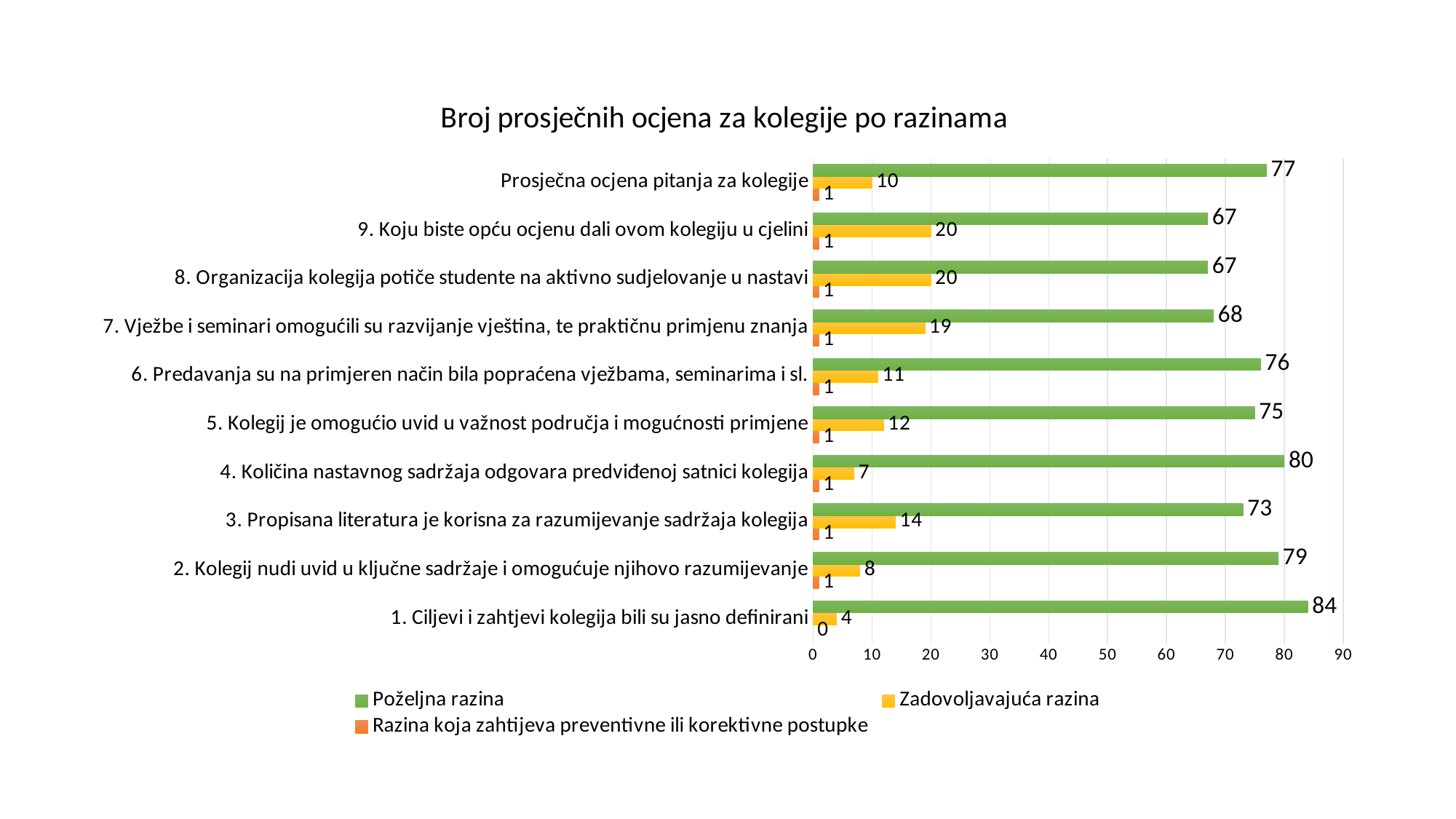
How many series does the legend list? 3 What is the value of 'Razina koja zahtijeva preventivne ili korektivne postupke' for '1. Ciljevi i zahtjevi kolegija bili su jasno definirani'? 0 How many categories are shown on the chart? 10 What is the total of the three values for 'Prosječna ocjena pitanja za kolegije'? 88 What is the title of the chart? Broj prosječnih ocjena za kolegije po razinama What is the value of 'Poželjna razina' for '1. Ciljevi i zahtjevi kolegija bili su jasno definirani'? 84 What kind of chart is shown on the slide? Bar chart Which category has the highest 'Poželjna razina' value? 1. Ciljevi i zahtjevi kolegija bili su jasno definirani What is the difference between the 'Poželjna razina' values for '4. Količina nastavnog sadržaja odgovara predviđenoj satnici kolegija' and '3. Propisana literatura je korisna za razumijevanje sadržaja kolegija'? 7 Which is larger: the 'Zadovoljavajuća razina' value for '5. Kolegij je omogućio uvid u važnost područja i mogućnosti primjene' or for '2. Kolegij nudi uvid u ključne sadržaje i omogućuje njihovo razumijevanje'? 5. Kolegij je omogućio uvid u važnost područja i mogućnosti primjene Which category has the lowest 'Zadovoljavajuća razina' value? 1. Ciljevi i zahtjevi kolegija bili su jasno definirani What is the value of 'Zadovoljavajuća razina' for '9. Koju biste opću ocjenu dali ovom kolegiju u cjelini'? 20